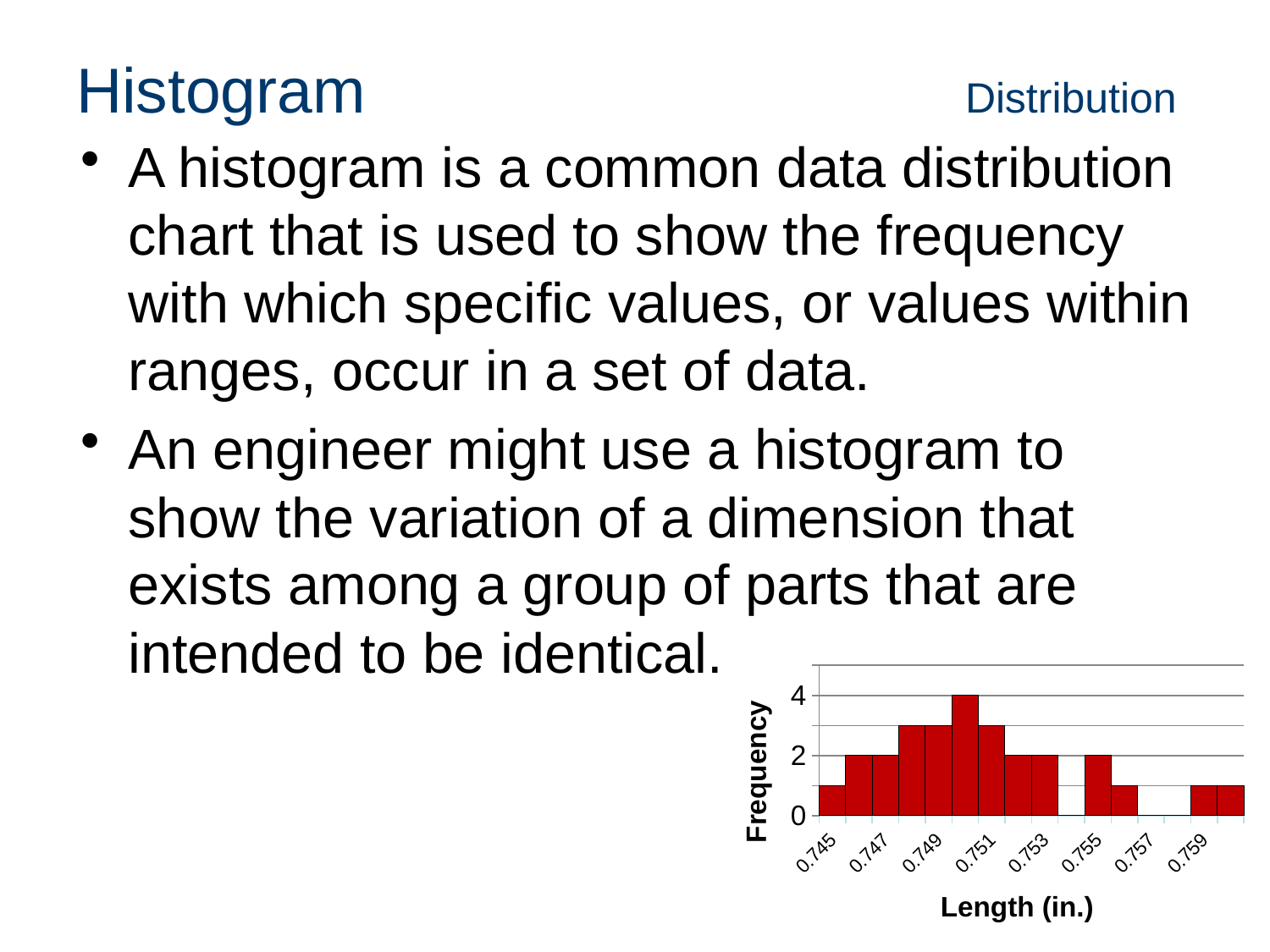
What is the difference between the frequency at 0.747 in. and the frequency at 0.757 in.? 2 What is the frequency for a length of 0.755 in.? 2 What type of chart is shown on the slide? bar chart What is the frequency for a length of 0.747 in.? 2 Which has the higher frequency, a length of 0.749 in. or 0.753 in.? 0.749 Is the frequency for a length of 0.745 in. greater or less than 2? less What is the frequency for a length of 0.757 in.? 0 What is the title of the horizontal axis of the histogram? Length (in.) What is the highest frequency reached by any bar in the histogram? 4 What is the frequency for a length of 0.753 in.? 2 Is the frequency for a length of 0.749 in. greater or less than 2? greater